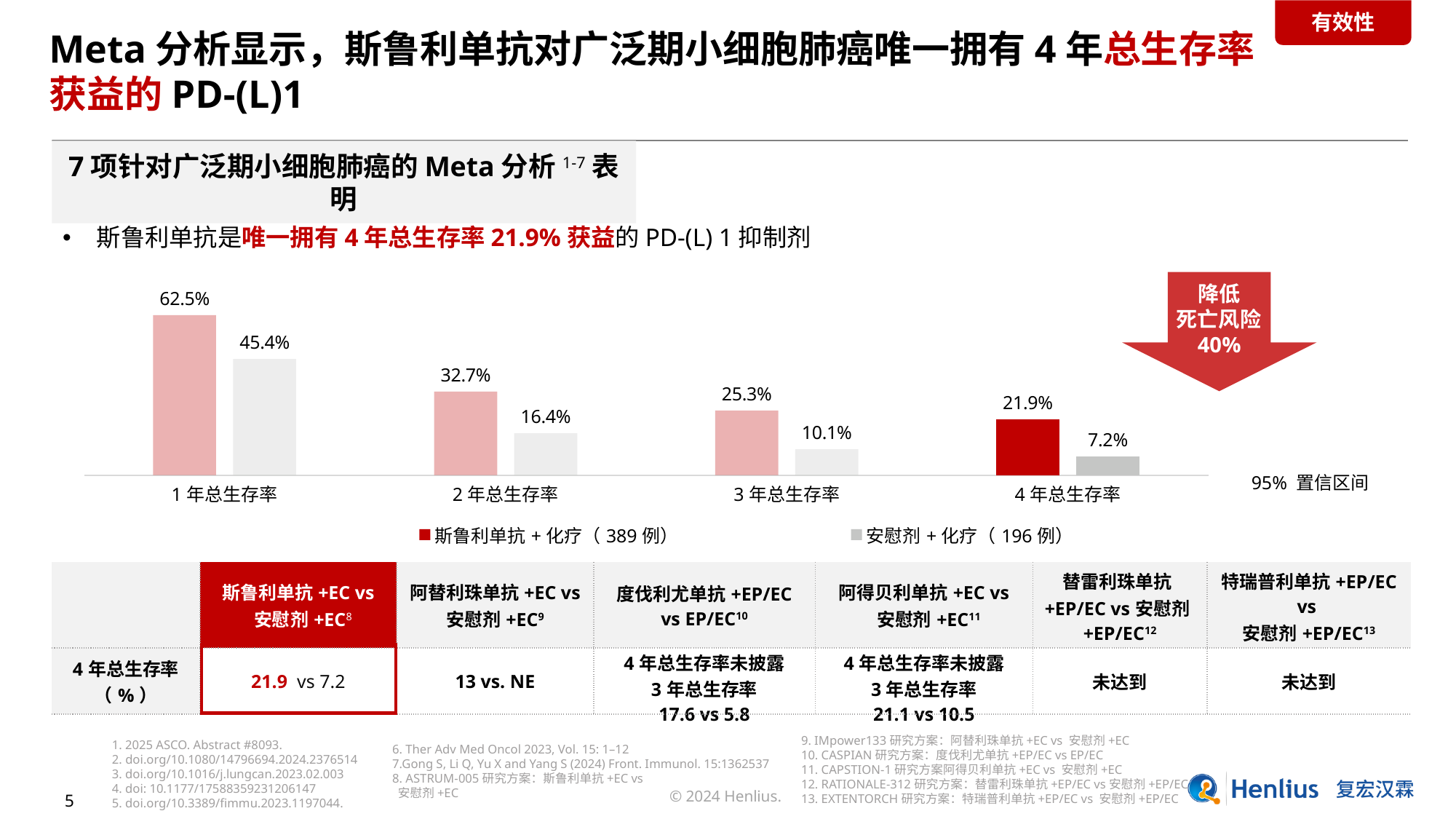
图表中，2 年总生存率上斯鲁利单抗 + 化疗组与安慰剂 + 化疗组相差多少个百分点？ 16.3 图表中，斯鲁利单抗 + 化疗组的 1 年总生存率是多少？ 62.5% 图表中，斯鲁利单抗 + 化疗组在哪个时间点的总生存率最高？ 1 年总生存率 图表的横轴上共有多少个时间点类别？ 4 图表中，4 年总生存率上斯鲁利单抗 + 化疗组与安慰剂 + 化疗组相差多少个百分点？ 14.7 图表的图例中列出了多少个系列？ 2 图表中，安慰剂 + 化疗组的 2 年总生存率是多少？ 16.4% 图表中，3 年总生存率哪一组更高：斯鲁利单抗 + 化疗组还是安慰剂 + 化疗组？ 斯鲁利单抗 + 化疗组 图表中，安慰剂 + 化疗组在哪个时间点的总生存率最低？ 4 年总生存率 图表中，斯鲁利单抗 + 化疗组的总生存率从 1 年到 4 年呈上升还是下降趋势？ 下降 图表中，安慰剂 + 化疗组的 4 年总生存率是多少？ 7.2% 图表中，斯鲁利单抗 + 化疗组的 3 年总生存率是多少？ 25.3%